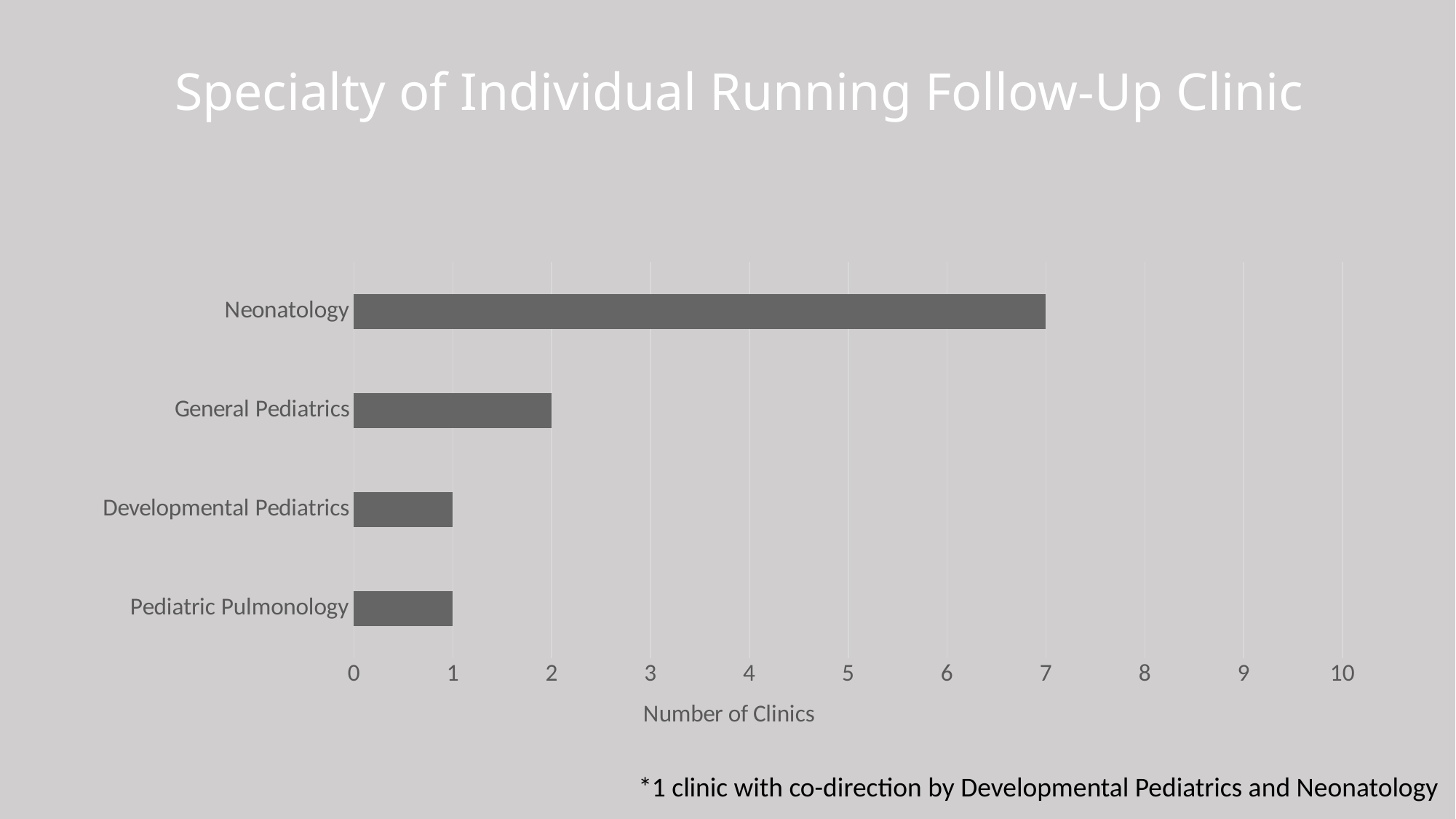
Which has more clinics, General Pediatrics or Developmental Pediatrics? General Pediatrics What is the number of clinics for Pediatric Pulmonology? 1 What is the number of clinics for General Pediatrics? 2 What is the number of clinics for Developmental Pediatrics? 1 Which specialty has the highest number of clinics? Neonatology How many specialties are shown in the chart? 4 Is the value for Neonatology greater or less than 5? greater What kind of chart is shown on the slide? bar chart What is the label of the horizontal axis? Number of Clinics What is the number of clinics for Neonatology? 7 What is the difference in number of clinics between Neonatology and General Pediatrics? 5 What is the title of the chart? Specialty of Individual Running Follow-Up Clinic